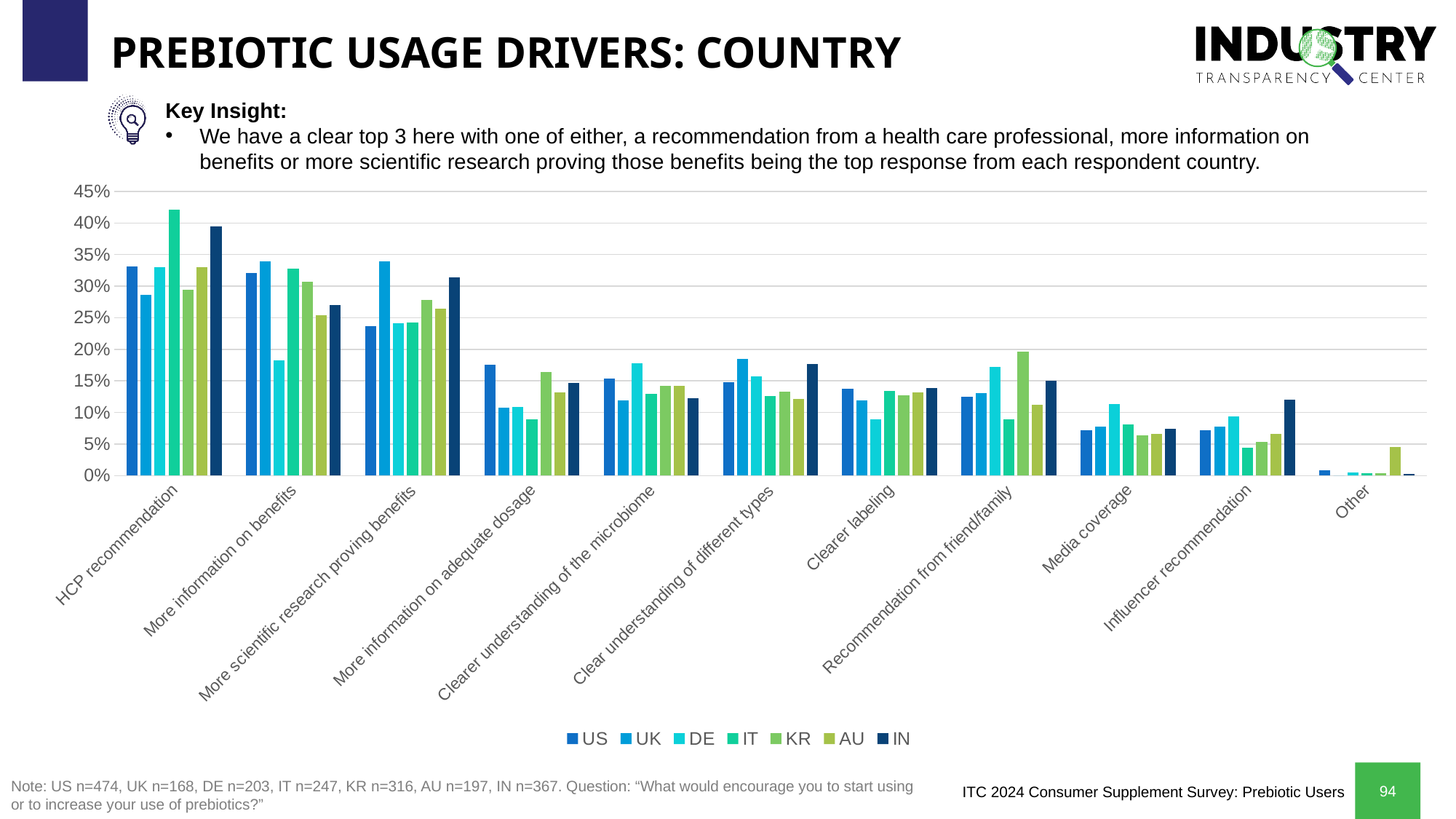
Is the value for UK in More information on benefits greater or less than 30%? greater In Recommendation from friend/family, which is larger, KR or IT? KR How many series does the legend list? 7 How many categories are shown along the x axis? 11 In Clear understanding of different types, which is larger, UK or KR? UK Which country has the highest bar in the Other category? AU Is the value for IT in HCP recommendation greater or less than 40%? greater Which series is listed last in the legend? IN Is the value for IN in Influencer recommendation greater or less than 10%? greater Which country has the highest bar for HCP recommendation? IT What kind of chart is shown on the slide? bar chart